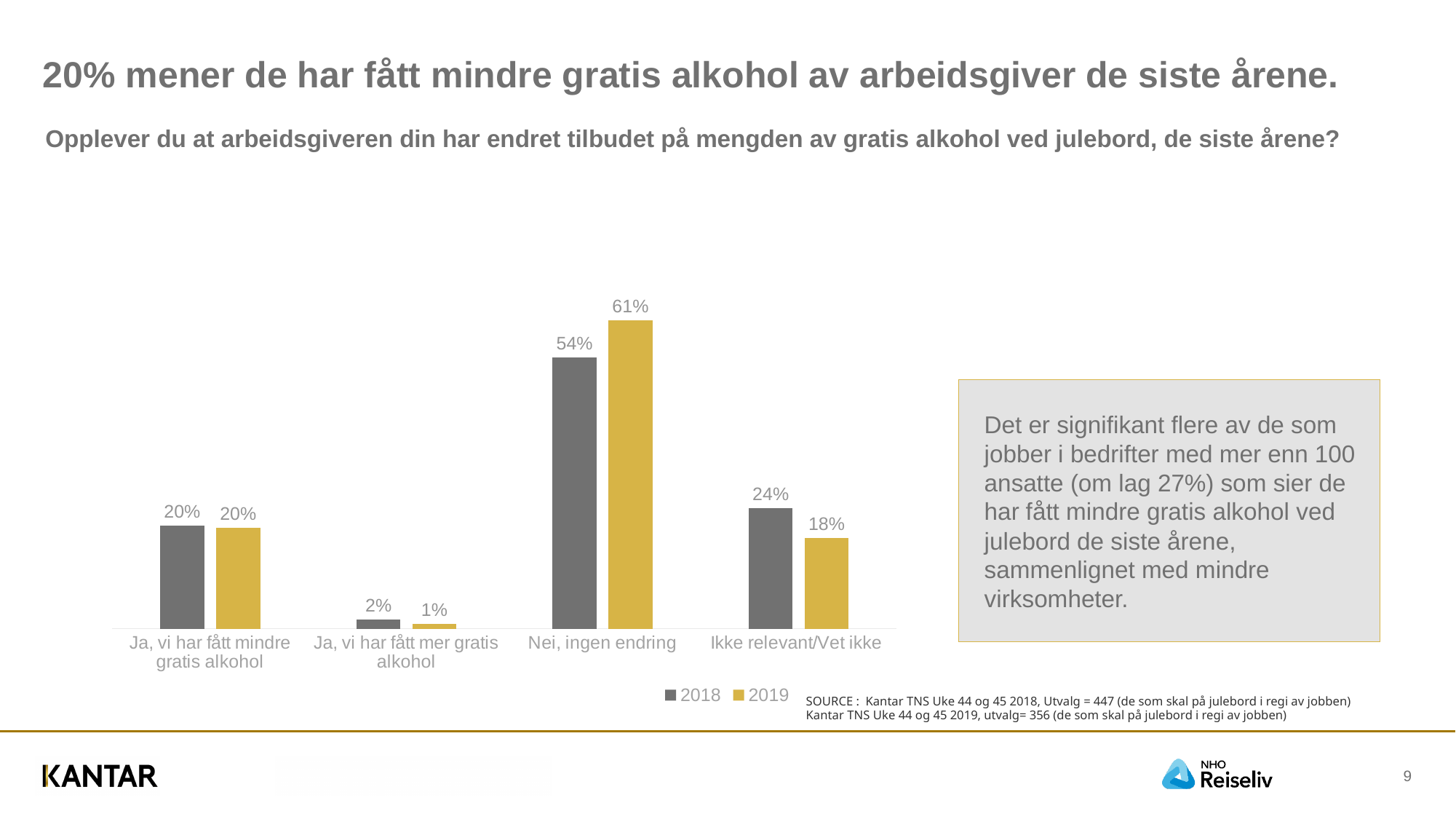
What is the 2018 value for "Ikke relevant/Vet ikke"? 24% What is the difference between the 2018 and 2019 values for "Ikke relevant/Vet ikke"? 6 percentage points Which category has the lowest value for the 2019 series? Ja, vi har fått mer gratis alkohol What is the difference between the 2019 and 2018 values for "Nei, ingen endring"? 7 percentage points What is the 2018 value for "Ja, vi har fått mindre gratis alkohol"? 20% For "Ikke relevant/Vet ikke", which year has the larger value, 2018 or 2019? 2018 What kind of chart is shown on the slide? Bar chart How many categories are shown on the x axis of the chart? 4 Which category has the highest value for the 2018 series? Nei, ingen endring What is the 2019 value for "Ja, vi har fått mer gratis alkohol"? 1% How many series does the legend list? 2 What is the 2019 value for "Nei, ingen endring"? 61%